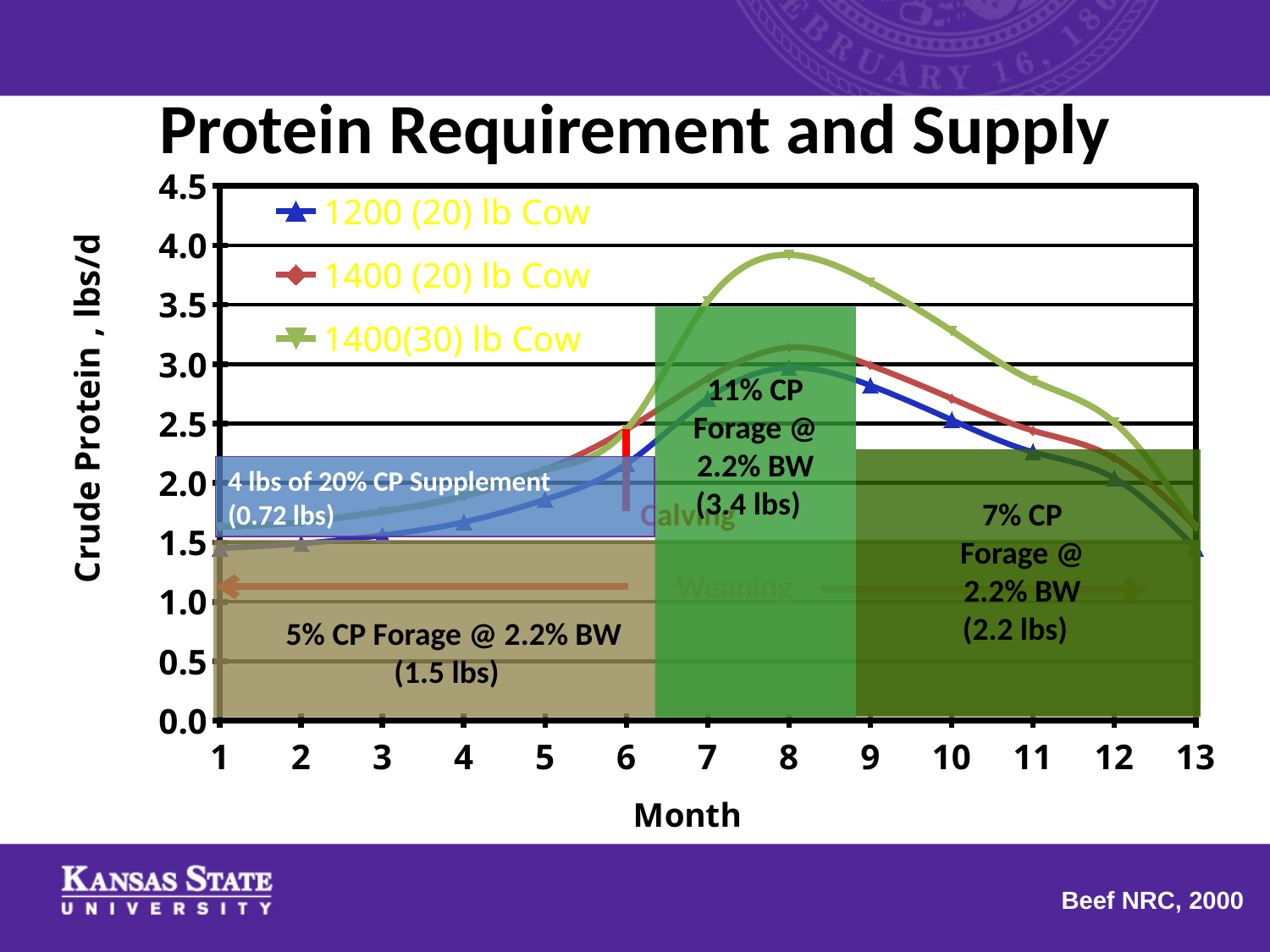
Which series has the highest value at month 8? 1400(30) lb Cow What is the label on the y axis? Crude Protein , lbs/d What kind of chart is shown on the slide? line chart At which month does the 1400(30) lb Cow series reach its peak? 8 At month 10, which is larger: the 1400(30) lb Cow or the 1200 (20) lb Cow? 1400(30) lb Cow Is the value for the 1400(30) lb Cow at month 8 greater or less than 3.5? greater Is the value for the 1200 (20) lb Cow at month 13 greater or less than 2.0? less What is the title of the chart? Protein Requirement and Supply How many series does the legend list? 3 Is the value for the 1400(30) lb Cow at month 10 greater or less than 3.0? greater How many months are marked along the x axis? 13 Do the values for the 1400(30) lb Cow rise or fall from month 8 to month 13? fall